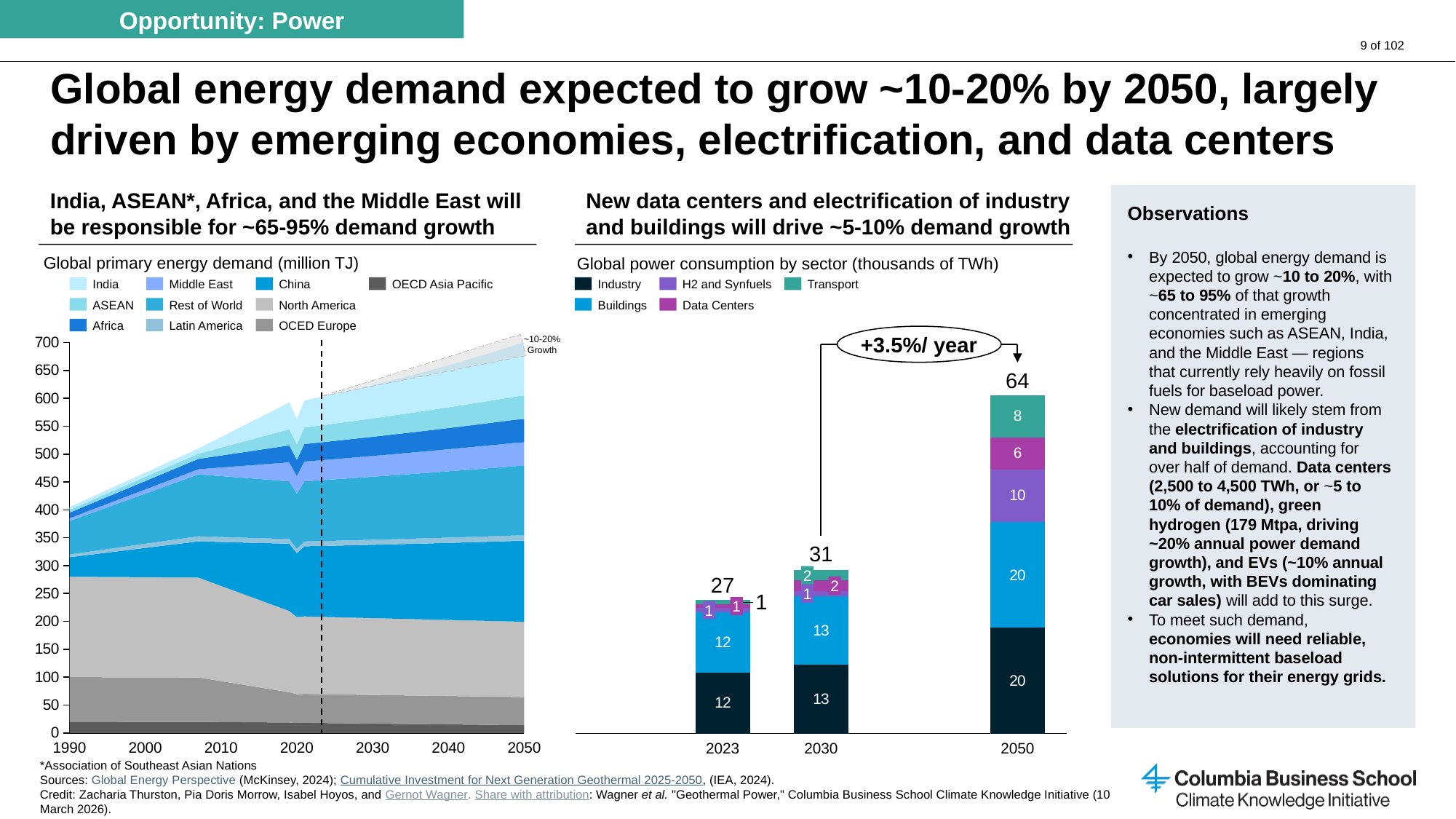
In the 'Global power consumption by sector' chart, what is the Buildings value for 2030? 13 How many series does the legend of the 'Global primary energy demand' chart list? 10 In the 'Global power consumption by sector' chart, is the Industry value for 2050 larger than the H2 and Synfuels value for 2050? Yes In the 'Global power consumption by sector' chart, what is the total for 2050? 64 In the 'Global power consumption by sector' chart, what is the Data Centers value for 2050? 6 In the 'Global power consumption by sector' chart, what is the Transport value for 2050? 8 What annual growth rate is annotated on the 'Global power consumption by sector' chart? +3.5%/ year How many series does the legend of the 'Global power consumption by sector' chart list? 5 What kind of chart is the 'Global power consumption by sector' chart on the right? bar chart In the 'Global power consumption by sector' chart, what is the difference between the 2050 total and the 2023 total? 37 In the 'Global power consumption by sector' chart, which year has the highest total? 2050 In the 'Global primary energy demand' chart, is the total demand in 1990 greater or less than 350? greater